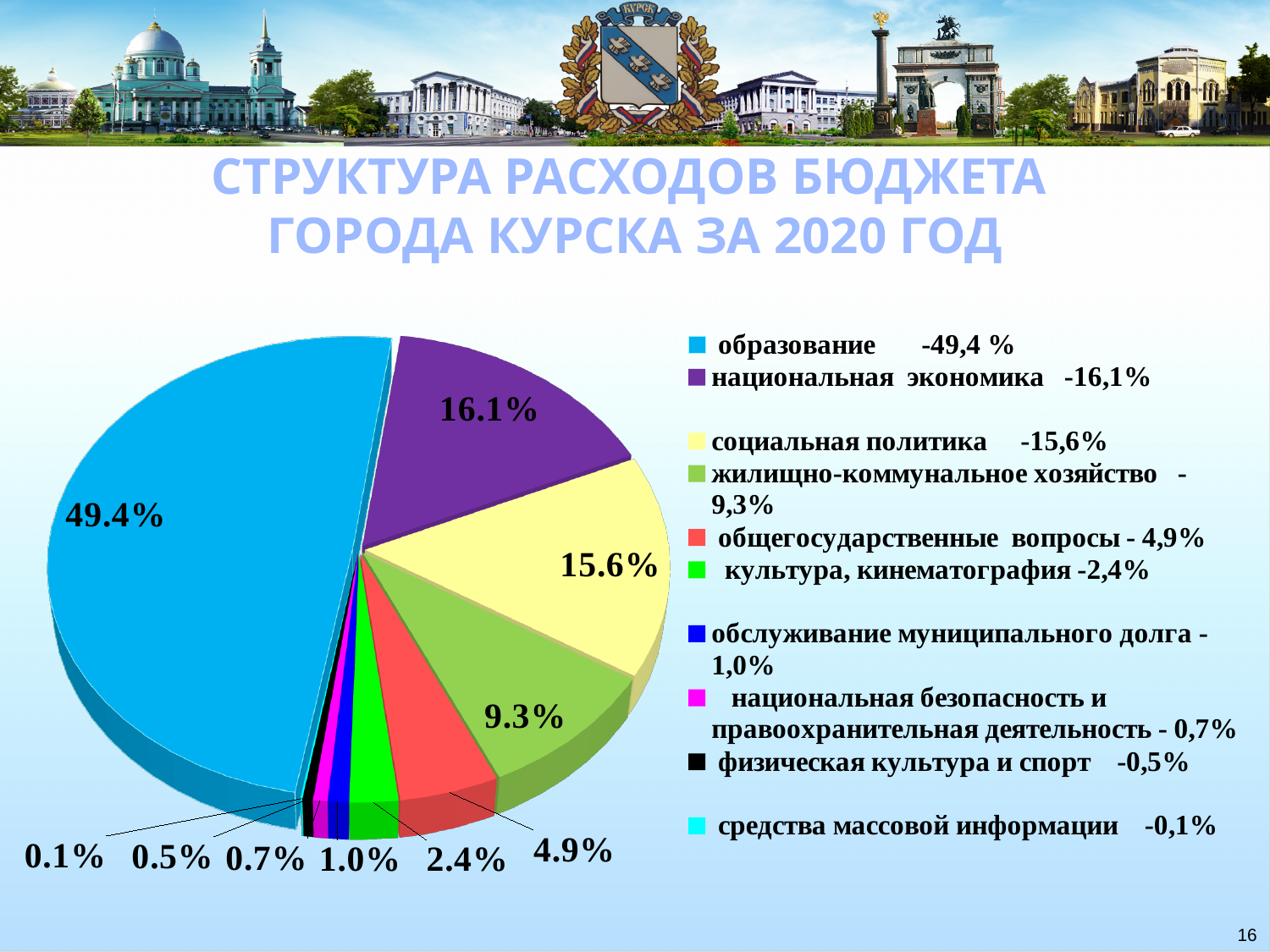
What is the difference between the shares for образование and жилищно-коммунальное хозяйство? 40.1% What is the value for национальная экономика? 16.1% What type of chart is shown on the slide? pie chart What is the value for жилищно-коммунальное хозяйство? 9.3% What is the difference between the shares for национальная экономика and социальная политика? 0.5% Which category has the smallest share of the pie? средства массовой информации What colour is the slice for социальная политика? yellow What is the value for культура, кинематография? 2.4% How many categories does the legend list? 10 Which category has the largest share of the pie? образование What share of the budget expenditure goes to образование (education)? 49.4% Which is larger: the share for общегосударственные вопросы or the share for обслуживание муниципального долга? общегосударственные вопросы